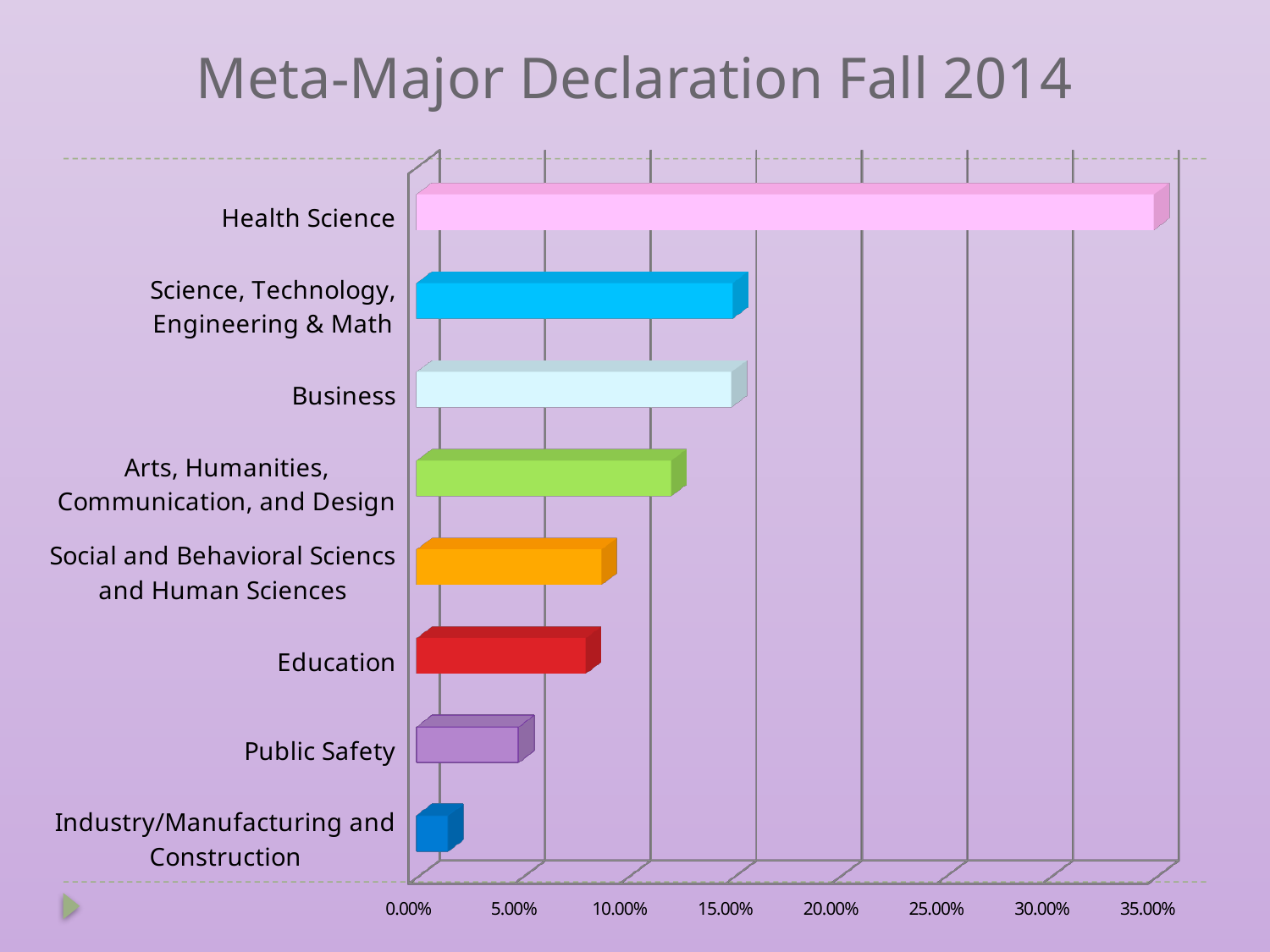
Which is larger, the value for Health Science or the value for Business? Health Science Is the value for Education greater or less than 10.00%? less Which meta-major has the lowest declaration percentage? Industry/Manufacturing and Construction How many meta-major categories are shown in the chart? 8 Is the value for Science, Technology, Engineering & Math greater or less than 20.00%? less What type of chart is shown on the slide? bar chart Which meta-major has the highest declaration percentage? Health Science Which is larger, the value for Public Safety or the value for Arts, Humanities, Communication, and Design? Arts, Humanities, Communication, and Design Is the value for Industry/Manufacturing and Construction greater or less than 5.00%? less What is the title of the chart? Meta-Major Declaration Fall 2014